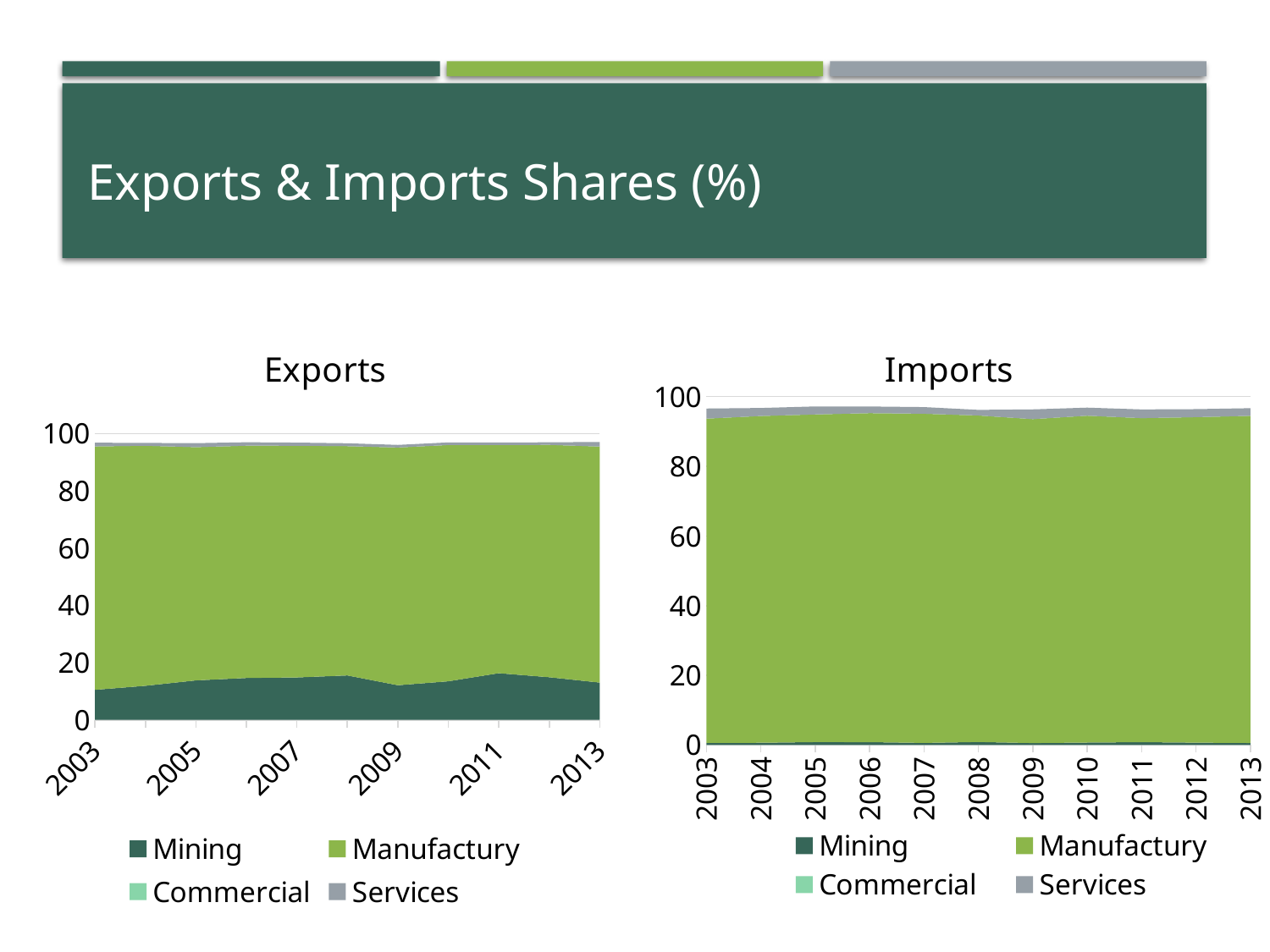
What kind of chart is the Exports chart? stacked area chart What kind of chart is the Imports chart? stacked area chart In the Exports chart, is the Mining share in 2013 greater or less than 40? less What are the first and last years shown on the x axis of the Exports chart? 2003 and 2013 How many series does the legend of the Imports chart list? 4 In the Imports chart, which series takes up the largest share across the years? Manufactury In the Exports chart, is the Mining share in 2003 greater or less than 20? less How many years are labelled on the x axis of the Imports chart? 11 In the Exports chart, which series has the largest share in 2013, Mining or Manufactury? Manufactury How many series does the legend of the Exports chart list? 4 What is the title of the chart on the left of the slide? Exports In the Imports chart, is the Mining share in 2003 greater or less than 20? less